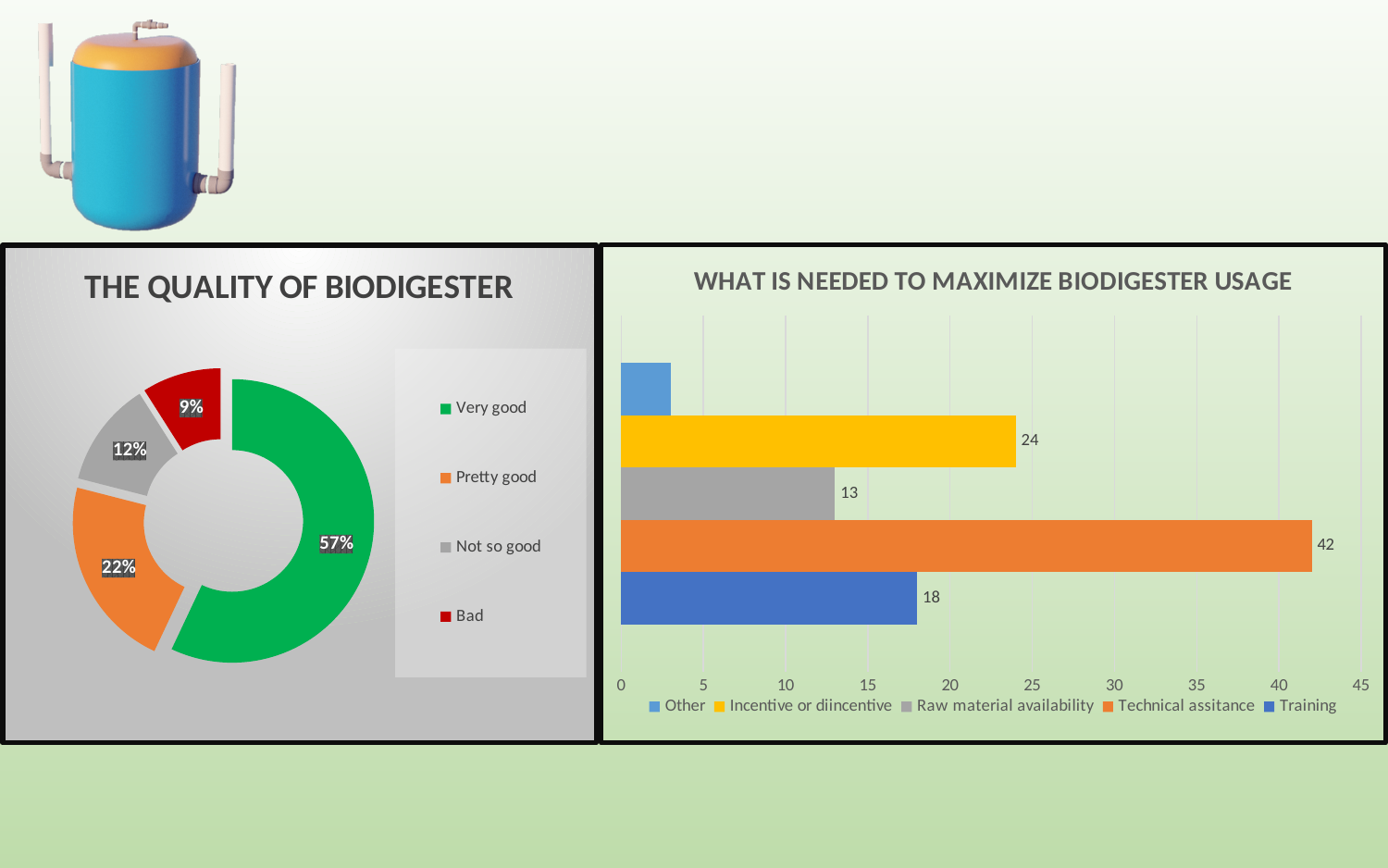
What kind of chart is 'WHAT IS NEEDED TO MAXIMIZE BIODIGESTER USAGE'? Bar chart In the chart titled 'WHAT IS NEEDED TO MAXIMIZE BIODIGESTER USAGE', is the value for 'Other' greater or less than 5? less How many categories does the legend of 'THE QUALITY OF BIODIGESTER' list? 4 In the chart titled 'WHAT IS NEEDED TO MAXIMIZE BIODIGESTER USAGE', what is the value for 'Technical assitance'? 42 In the chart titled 'THE QUALITY OF BIODIGESTER', what share of responses is 'Very good'? 57% In the chart titled 'WHAT IS NEEDED TO MAXIMIZE BIODIGESTER USAGE', what is the difference between 'Incentive or diincentive' and 'Training'? 6 In the chart titled 'THE QUALITY OF BIODIGESTER', what is the difference in percentage points between 'Pretty good' and 'Not so good'? 10 In the chart titled 'WHAT IS NEEDED TO MAXIMIZE BIODIGESTER USAGE', which is larger: 'Raw material availability' or 'Training'? Training In the chart titled 'THE QUALITY OF BIODIGESTER', which category has the smallest share? Bad In the chart titled 'WHAT IS NEEDED TO MAXIMIZE BIODIGESTER USAGE', which item has the highest value? Technical assitance In the chart titled 'THE QUALITY OF BIODIGESTER', what percentage is shown for 'Bad'? 9% What kind of chart is 'THE QUALITY OF BIODIGESTER'? Doughnut chart